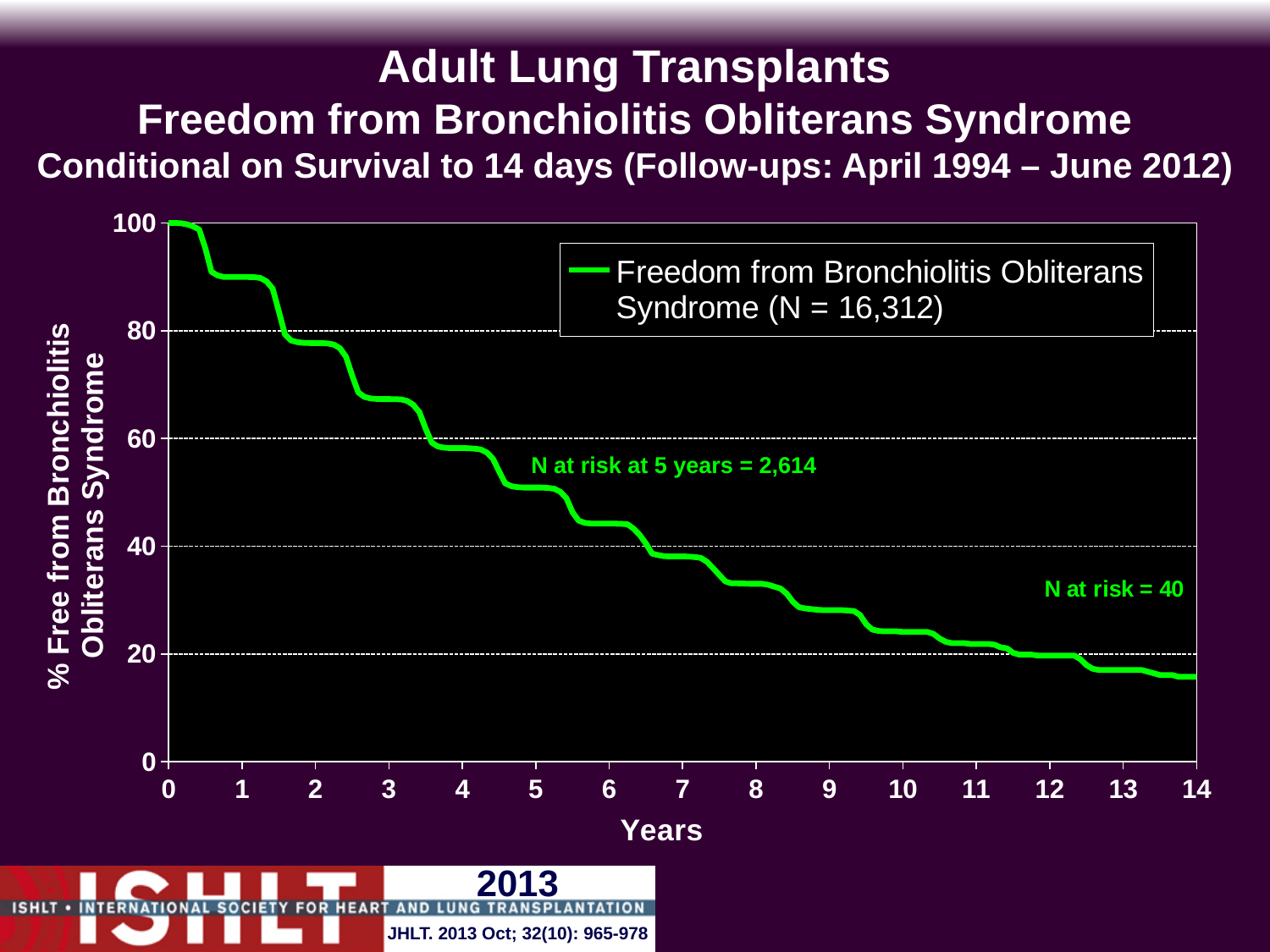
Does the percentage free from Bronchiolitis Obliterans Syndrome rise or fall as years increase? fall How many series does the legend list? 1 What is the label of the x axis? Years Is the value for % free from Bronchiolitis Obliterans Syndrome at 1 year greater or less than 80? greater Is the value for % free from Bronchiolitis Obliterans Syndrome at 3 years greater or less than 60? greater What is the N given in the legend for Freedom from Bronchiolitis Obliterans Syndrome? 16,312 Is the value for % free from Bronchiolitis Obliterans Syndrome at 10 years greater or less than 40? less What is the N at risk at 5 years according to the annotation on the chart? 2,614 What is the N at risk shown at the right end of the curve? 40 What kind of chart is shown on the slide? line chart